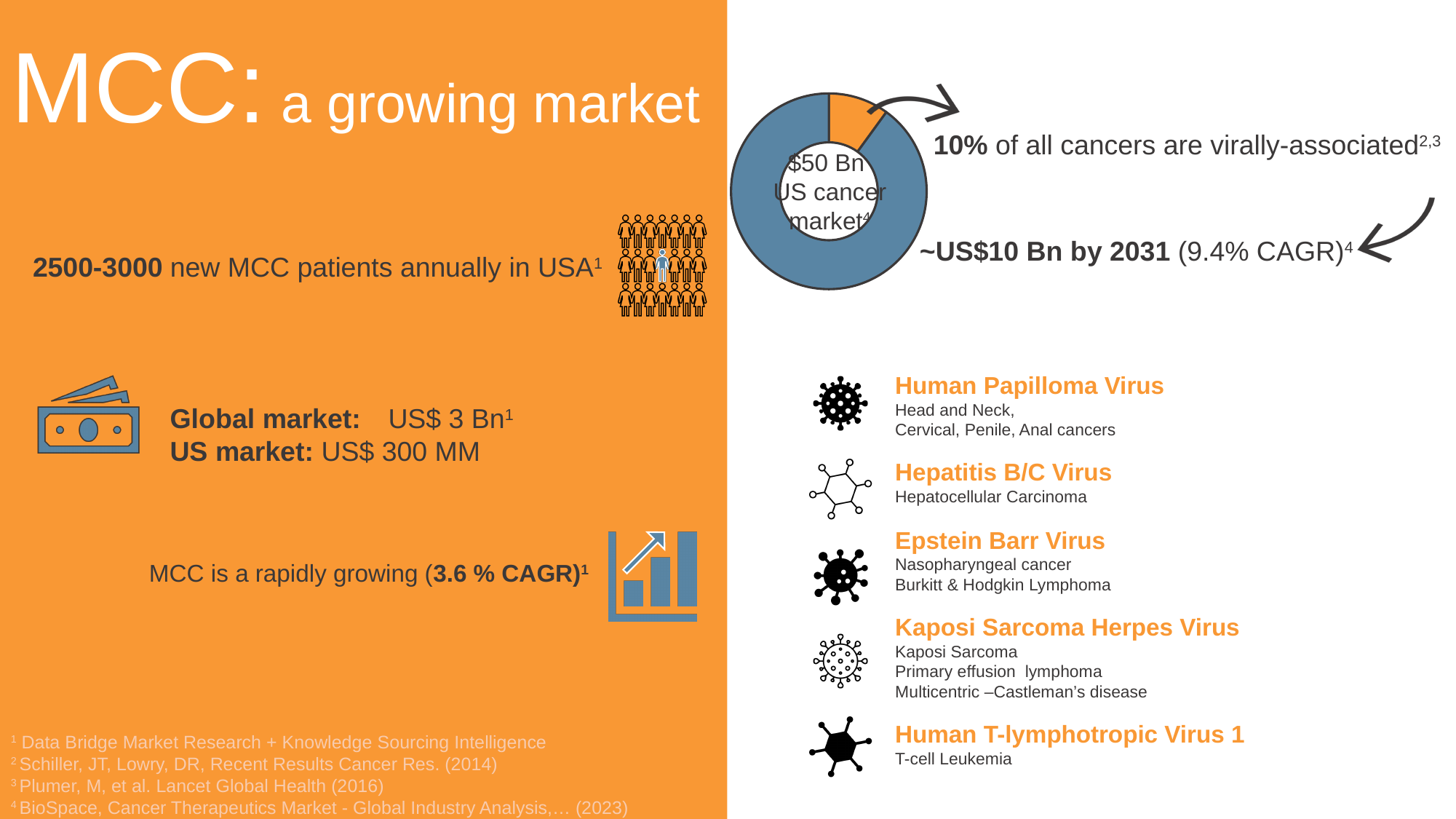
Which slice of the donut chart is larger, the blue one or the orange one? Blue What text is printed in the centre of the donut chart? $50 Bn US cancer market How many slices does the donut chart have? 2 What CAGR is given in the annotation pointing to the donut chart for the ~US$10 Bn by 2031 figure? 9.4% What kind of chart is shown on the right side of the slide? Pie chart (donut) What share of the donut chart does the orange slice represent? 10% What total US cancer market value is shown in the donut chart? $50 Bn What colour is the slice of the donut chart representing virally-associated cancers? Orange Is the share of the orange slice in the donut chart greater or less than 50%? less According to the annotation next to the donut chart, what percentage of all cancers are virally-associated? 10%